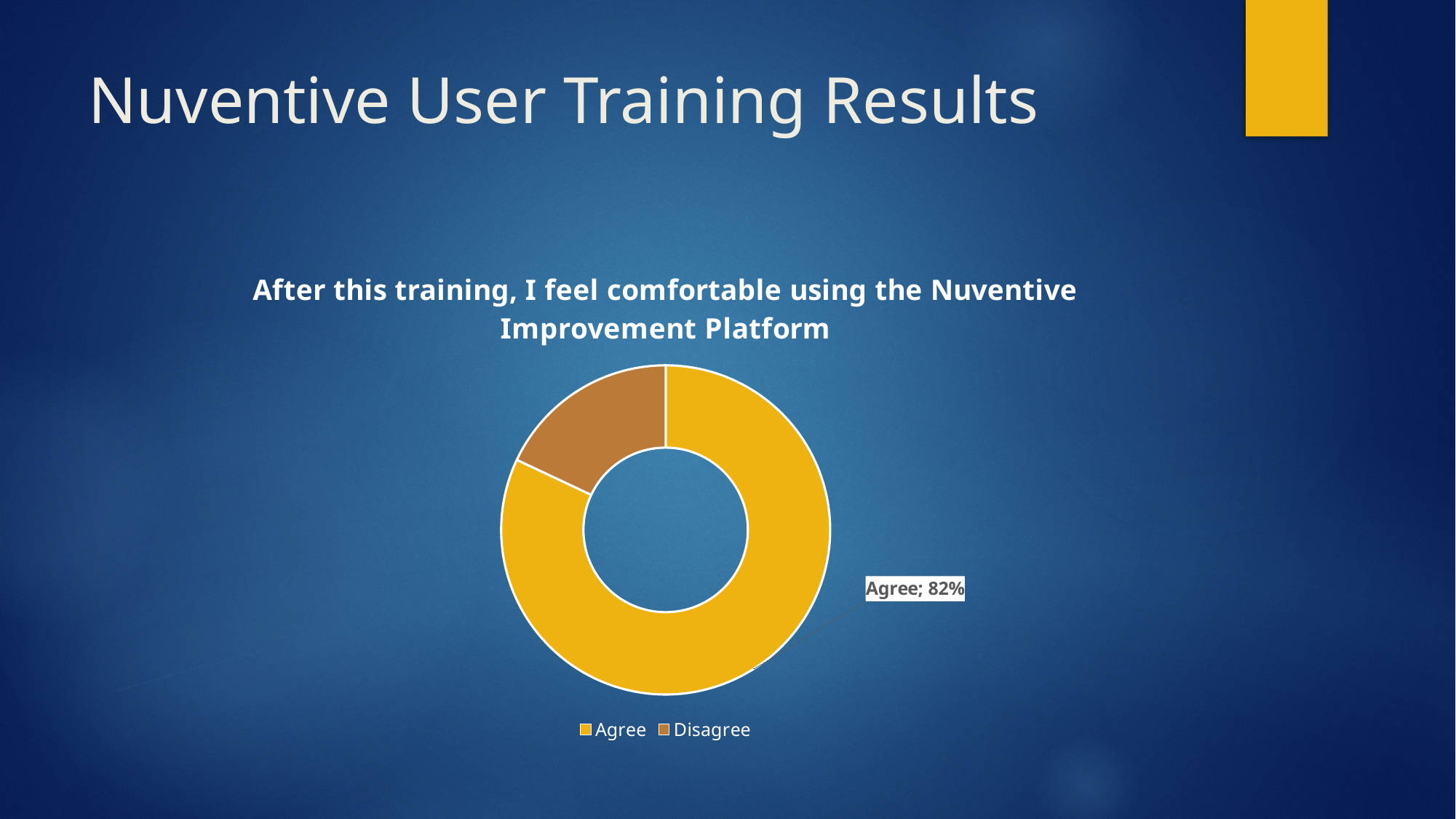
Which category has the smallest share of the chart? Disagree How many categories are shown in the chart? 2 What colour is the Agree slice in the chart? Yellow Which category has the largest share of the chart? Agree How many entries does the chart legend list? 2 What percentage of respondents chose Agree in the chart? 82% What kind of chart is shown on the slide? Doughnut (pie) chart Which is larger, the Agree slice or the Disagree slice? Agree What is the title of the chart? After this training, I feel comfortable using the Nuventive Improvement Platform